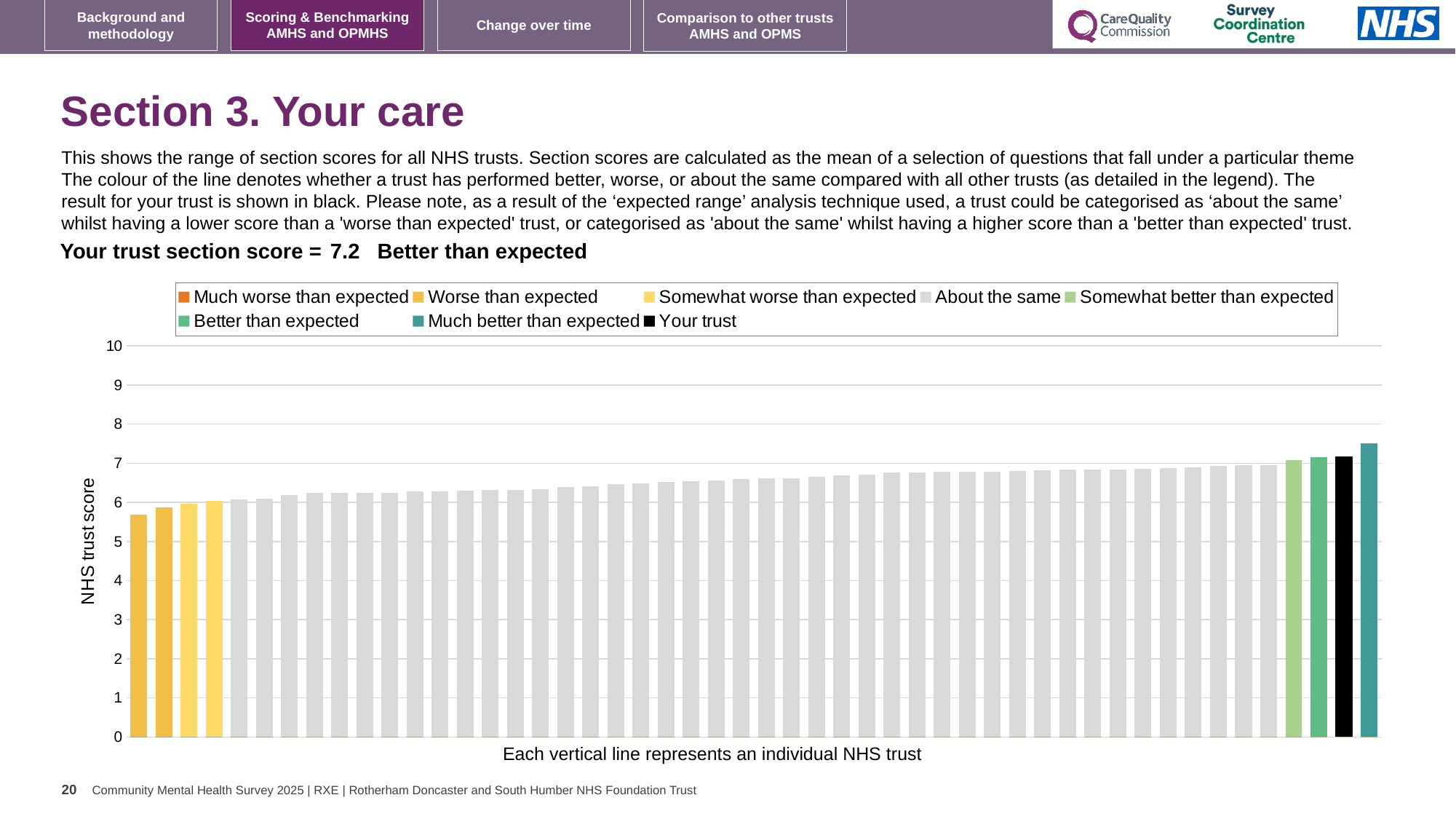
Do the bar values rise or fall moving from left to right along the x axis? Rise What is the section score for your trust shown on the slide? 7.2 Is the value for your trust's bar greater or less than 6? greater Is the value of the highest bar on the chart greater or less than 7? greater Which performance category is your trust placed in for Section 3. Your care? Better than expected Is the value of the lowest bar on the chart greater or less than 6? less What kind of chart is shown on the slide? Bar chart How many entries does the chart legend list? 8 What is the label on the vertical axis of the chart? NHS trust score Which is higher: your trust's black bar or the teal 'Much better than expected' bar to its right? The teal 'Much better than expected' bar How many bars are coloured teal for 'Much better than expected'? 1 What colour is used for the bar representing your trust? Black